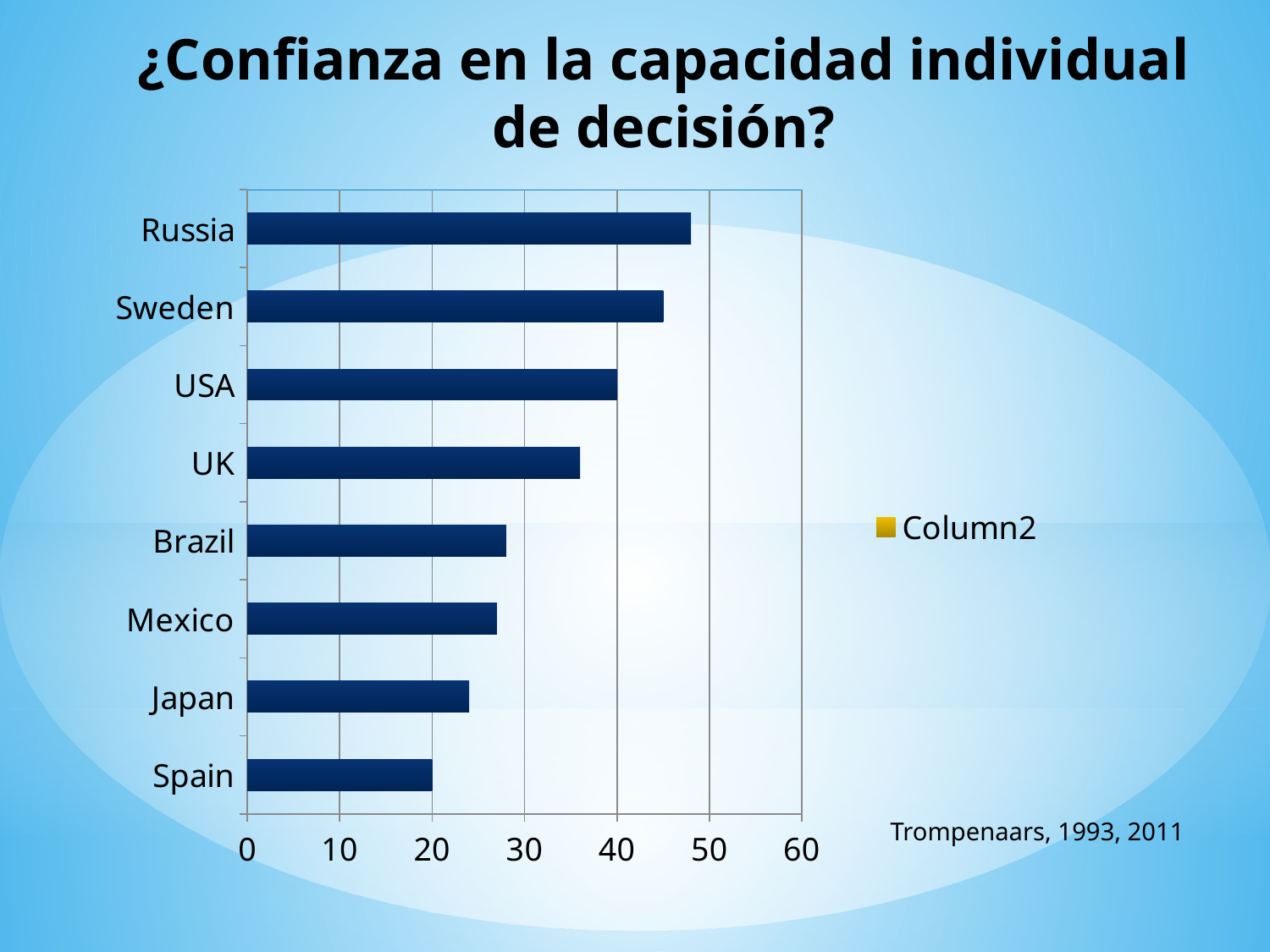
What kind of chart is shown on the slide? bar chart Is the value for Russia greater or less than 40? greater Which has a larger value, UK or Brazil? UK What is the name of the series listed in the chart legend? Column2 Is the value for UK greater or less than 40? less Which has a larger value, Japan or Sweden? Sweden Is the value for Japan greater or less than 20? greater How many countries are shown on the chart? 8 How many series does the legend list? 1 Which country has the highest value on the chart? Russia Which country has the lowest value on the chart? Spain